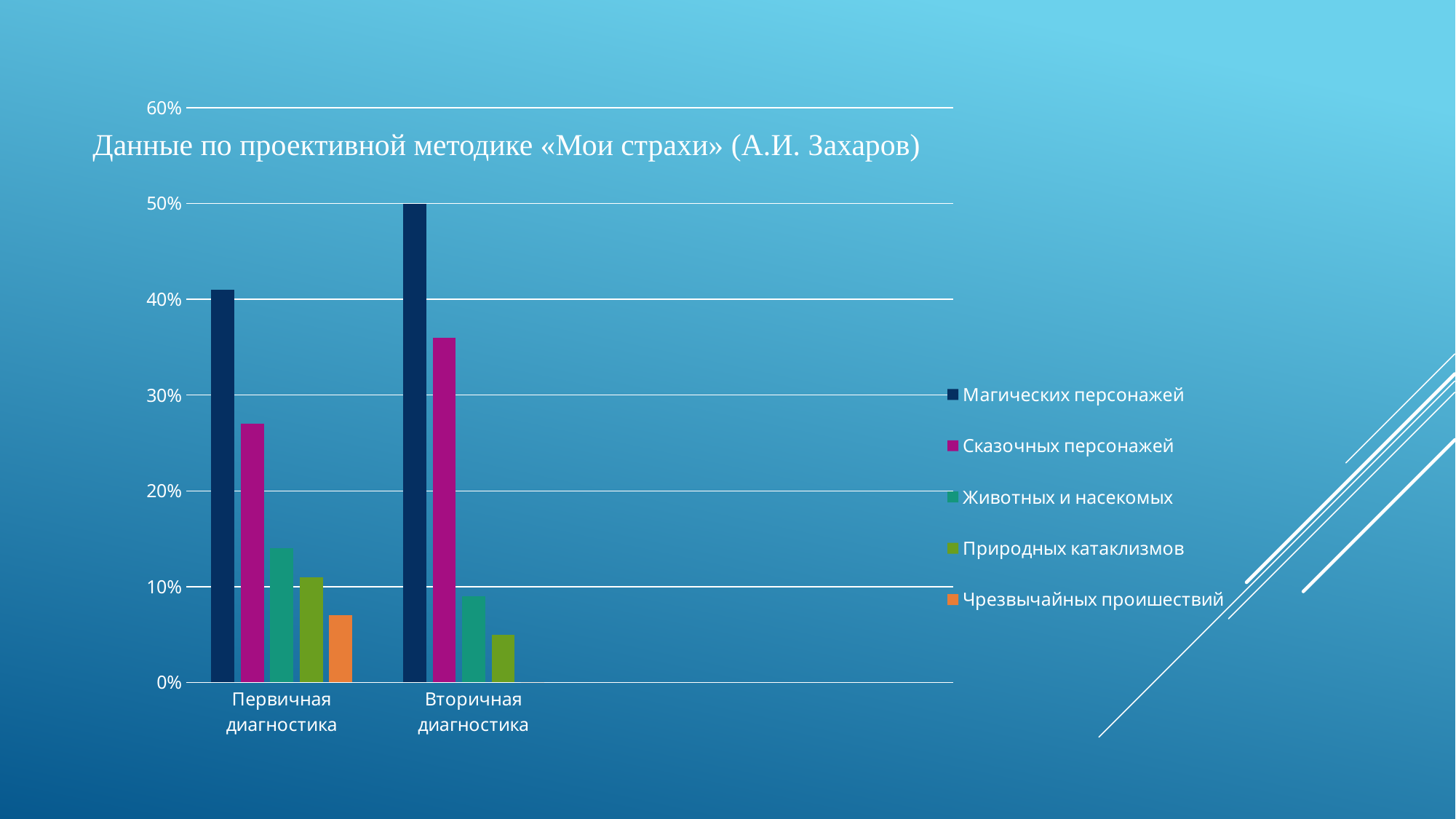
How many series does the legend list? 5 Is the value for Магических персонажей in Первичная диагностика greater or less than 40%? greater Which series has the lowest value in the Первичная диагностика category? Чрезвычайных проишествий Does the value for Природных катаклизмов rise or fall from Первичная диагностика to Вторичная диагностика? fall What is the title of the chart? Данные по проективной методике «Мои страхи» (А.И. Захаров) Is the value for Животных и насекомых in Вторичная диагностика greater or less than 10%? less Which series has the highest value in the Первичная диагностика category? Магических персонажей Is the value for Сказочных персонажей in Вторичная диагностика greater or less than 30%? greater What kind of chart is shown on the slide? bar chart How many categories are shown on the x axis? 2 Which is larger: Магических персонажей in Первичная диагностика or Магических персонажей in Вторичная диагностика? Вторичная диагностика